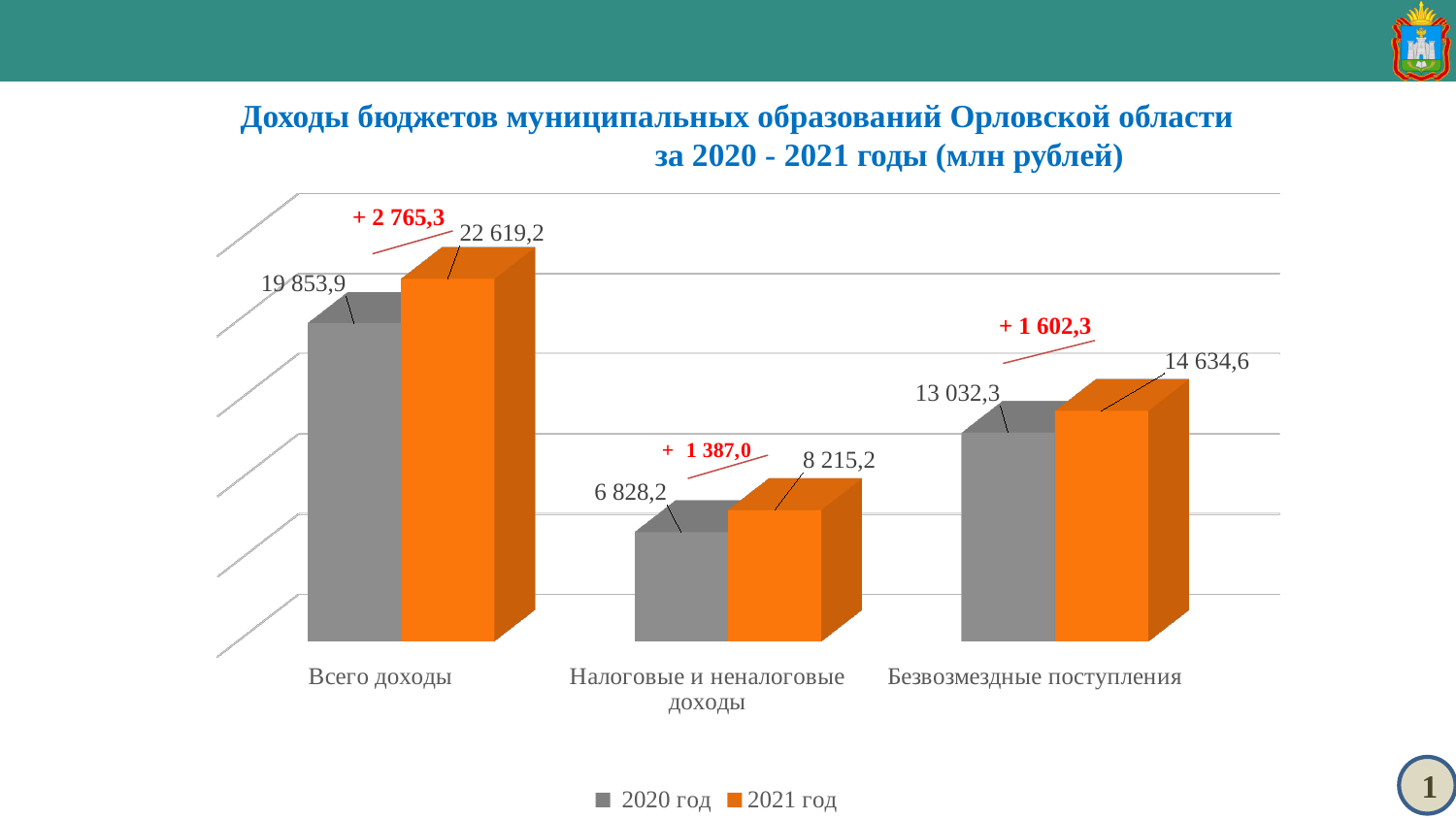
How many categories are shown on the x axis? 3 Which category has the highest value in 2020 год? Всего доходы What is the value for Всего доходы in 2020 год? 19 853,9 What is the value for Безвозмездные поступления in 2021 год? 14 634,6 What kind of chart is shown on the slide? Bar chart What is the difference between the 2021 год and 2020 год values for Безвозмездные поступления? 1 602,3 What is the value for Налоговые и неналоговые доходы in 2020 год? 6 828,2 Which is larger for Налоговые и неналоговые доходы: the 2020 год value or the 2021 год value? 2021 год How many series does the legend list? 2 What is the difference between the 2021 год and 2020 год values for Всего доходы? 2 765,3 What is the value for Всего доходы in 2021 год? 22 619,2 Which category has the lowest value in 2021 год? Налоговые и неналоговые доходы